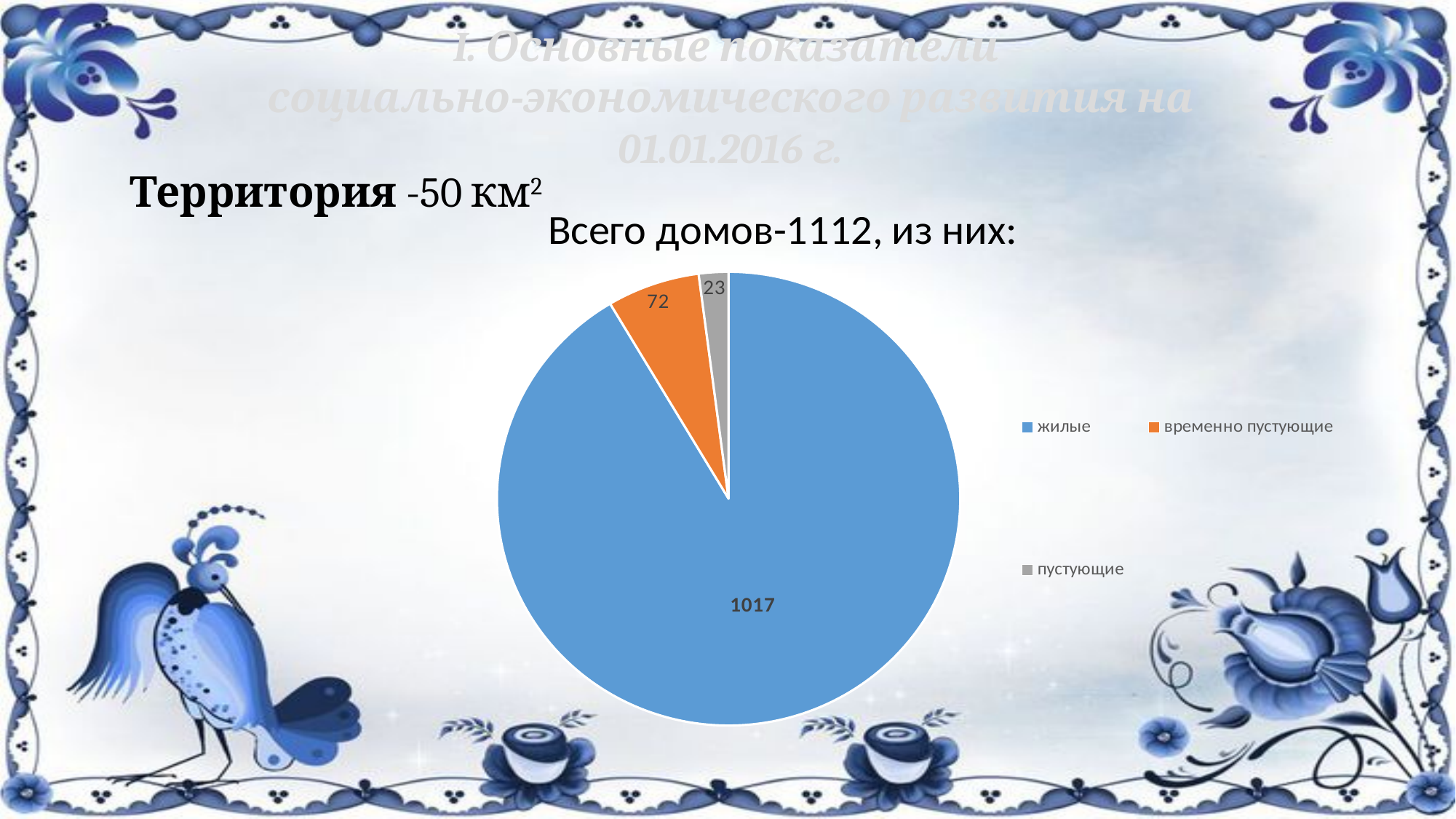
Which is larger: "временно пустующие" or "пустующие"? временно пустующие What is the title of the pie chart? Всего домов-1112, из них: Which category has the largest slice in the pie chart? жилые What value is shown for "временно пустующие" in the pie chart? 72 What value is shown for "пустующие" in the pie chart? 23 How many houses are in the "жилые" slice of the pie chart? 1017 How many categories does the pie chart show? 3 What is the total of all three slices in the pie chart? 1112 What is the difference between the values for "временно пустующие" and "пустующие"? 49 By how much does the "жилые" value exceed the "временно пустующие" value? 945 What type of chart is shown on the slide? pie chart Which category has the smallest slice in the pie chart? пустующие